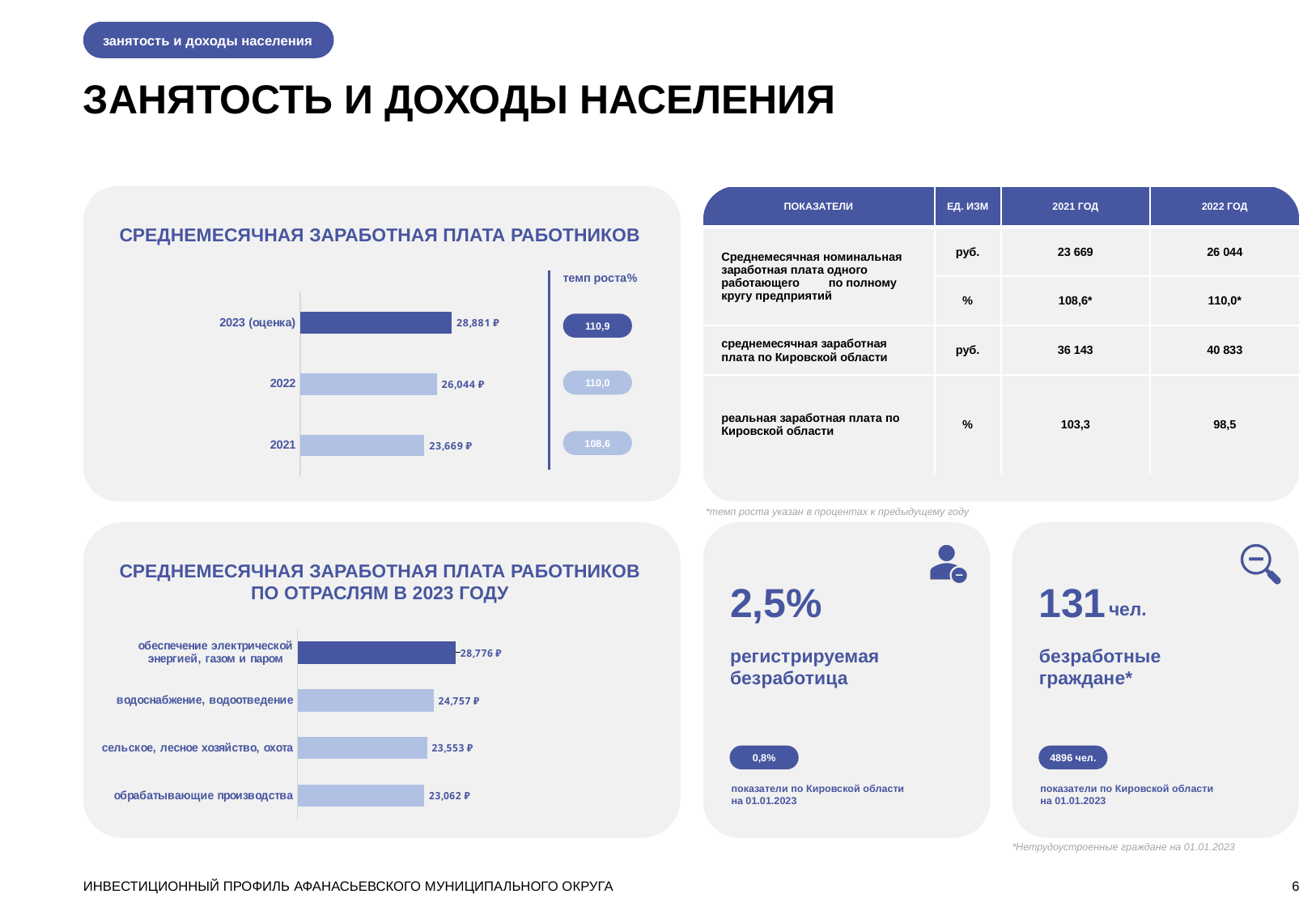
In the chart 'СРЕДНЕМЕСЯЧНАЯ ЗАРАБОТНАЯ ПЛАТА РАБОТНИКОВ', what is the difference between the 2023 (оценка) value and the 2021 value? 5,212 ₽ What kind of chart is 'СРЕДНЕМЕСЯЧНАЯ ЗАРАБОТНАЯ ПЛАТА РАБОТНИКОВ ПО ОТРАСЛЯМ В 2023 ГОДУ'? bar chart In the chart 'СРЕДНЕМЕСЯЧНАЯ ЗАРАБОТНАЯ ПЛАТА РАБОТНИКОВ', what is the темп роста% shown for 2023 (оценка)? 110,9 In the chart 'СРЕДНЕМЕСЯЧНАЯ ЗАРАБОТНАЯ ПЛАТА РАБОТНИКОВ ПО ОТРАСЛЯМ В 2023 ГОДУ', which is larger: the value for 'сельское, лесное хозяйство, охота' or for 'обрабатывающие производства'? сельское, лесное хозяйство, охота In the chart 'СРЕДНЕМЕСЯЧНАЯ ЗАРАБОТНАЯ ПЛАТА РАБОТНИКОВ', what is the value for 2022? 26,044 ₽ In the chart 'СРЕДНЕМЕСЯЧНАЯ ЗАРАБОТНАЯ ПЛАТА РАБОТНИКОВ ПО ОТРАСЛЯМ В 2023 ГОДУ', how many industries are plotted? 4 In the chart 'СРЕДНЕМЕСЯЧНАЯ ЗАРАБОТНАЯ ПЛАТА РАБОТНИКОВ', what is the value for 2023 (оценка)? 28,881 ₽ In the chart 'СРЕДНЕМЕСЯЧНАЯ ЗАРАБОТНАЯ ПЛАТА РАБОТНИКОВ ПО ОТРАСЛЯМ В 2023 ГОДУ', which industry has the lowest value? обрабатывающие производства In the chart 'СРЕДНЕМЕСЯЧНАЯ ЗАРАБОТНАЯ ПЛАТА РАБОТНИКОВ ПО ОТРАСЛЯМ В 2023 ГОДУ', what is the value for 'водоснабжение, водоотведение'? 24,757 ₽ In the chart 'СРЕДНЕМЕСЯЧНАЯ ЗАРАБОТНАЯ ПЛАТА РАБОТНИКОВ', which year has the lowest value? 2021 In the chart 'СРЕДНЕМЕСЯЧНАЯ ЗАРАБОТНАЯ ПЛАТА РАБОТНИКОВ', how many years are plotted? 3 In the chart 'СРЕДНЕМЕСЯЧНАЯ ЗАРАБОТНАЯ ПЛАТА РАБОТНИКОВ ПО ОТРАСЛЯМ В 2023 ГОДУ', which industry has the highest value? обеспечение электрической энергией, газом и паром